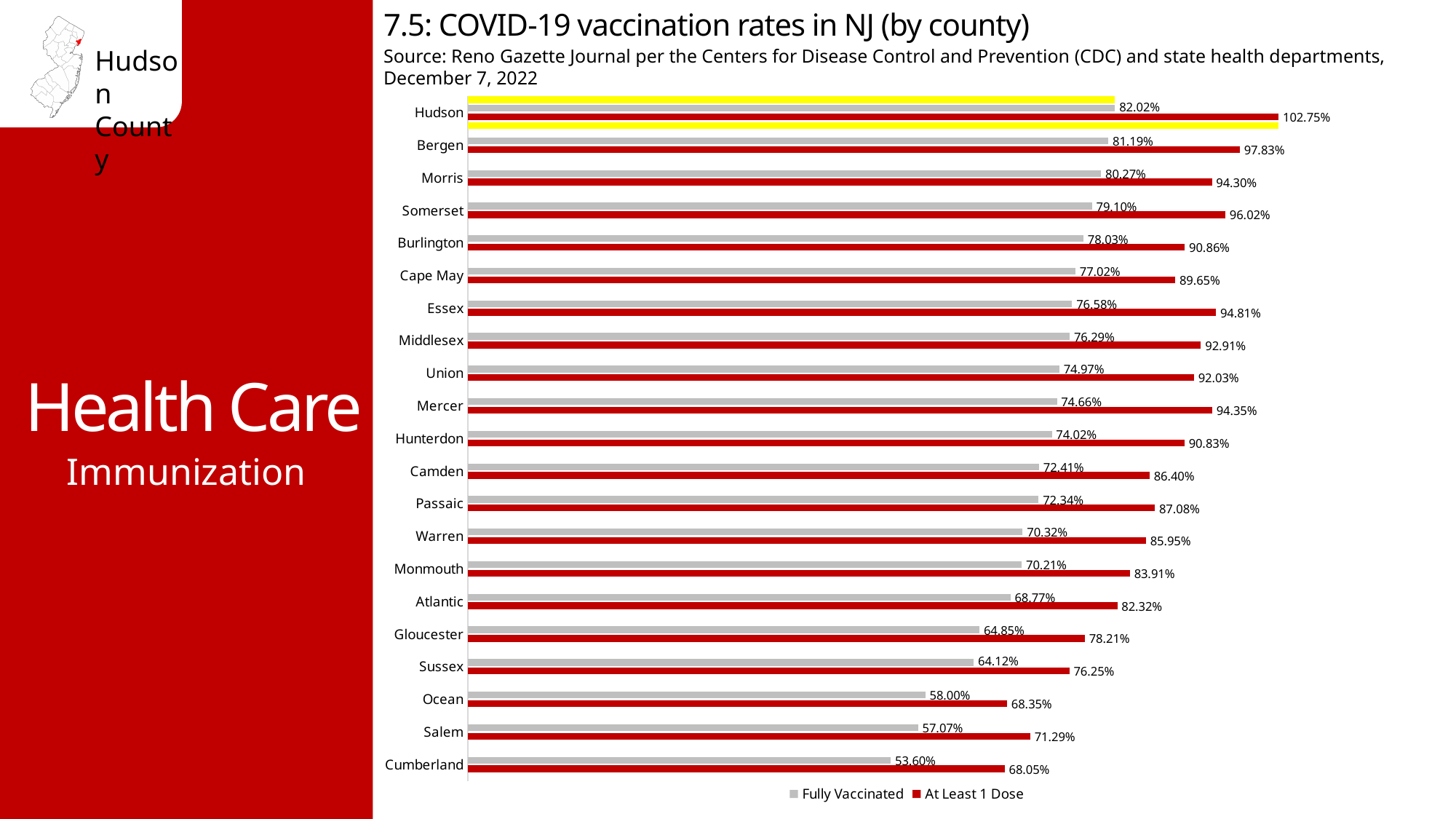
How many counties are shown in the chart? 21 What colour are the At Least 1 Dose bars? Red Which county has the highest At Least 1 Dose rate? Hudson Which county has the lowest Fully Vaccinated rate? Cumberland What is the Fully Vaccinated rate for Hudson county? 82.02% Which county has a higher Fully Vaccinated rate, Morris or Ocean? Morris How many series does the legend list? 2 What is the At Least 1 Dose rate for Mercer county? 94.35% What type of chart is shown on the slide? Bar chart What is the difference between the At Least 1 Dose rate and the Fully Vaccinated rate for Hudson county? 20.73% What is the Fully Vaccinated rate for Cumberland county? 53.60% What is the At Least 1 Dose rate for Bergen county? 97.83%